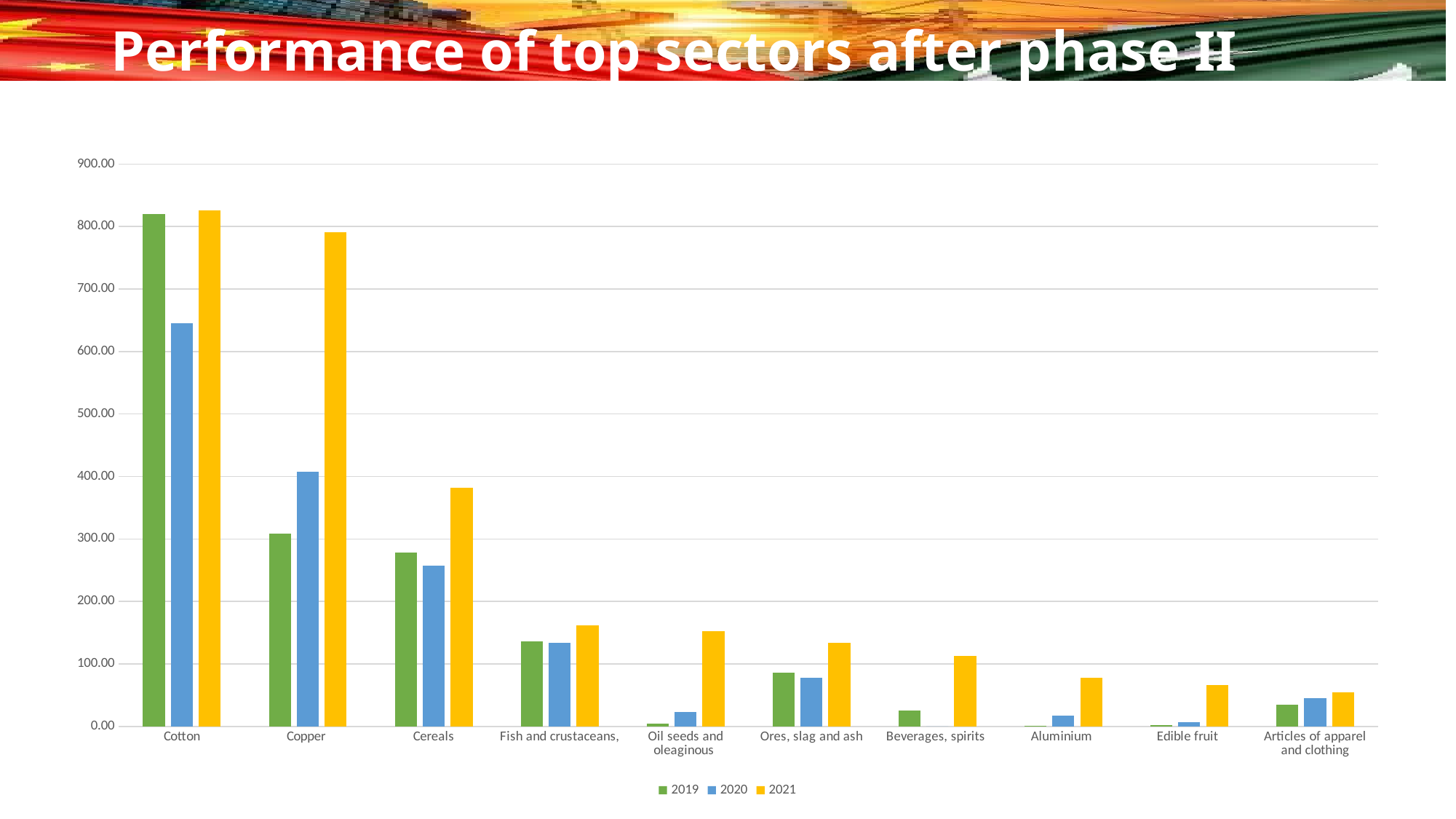
What kind of chart is shown on the slide? bar chart Is the 2021 value for Copper greater or less than 700? greater Is the 2020 value for Cotton greater or less than 600? greater Which is larger: the 2020 value for Copper or the 2020 value for Cereals? Copper Which sector has the highest value for 2021? Cotton How many series does the legend list? 3 How many sectors (categories) are shown on the x axis? 10 Is the 2021 value for Aluminium greater or less than 100? less Do the 2021 values generally rise or fall moving from Cotton on the left to Articles of apparel and clothing on the right? fall Which sector has the highest value for 2020? Cotton What is the title of the chart slide? Performance of top sectors after phase II